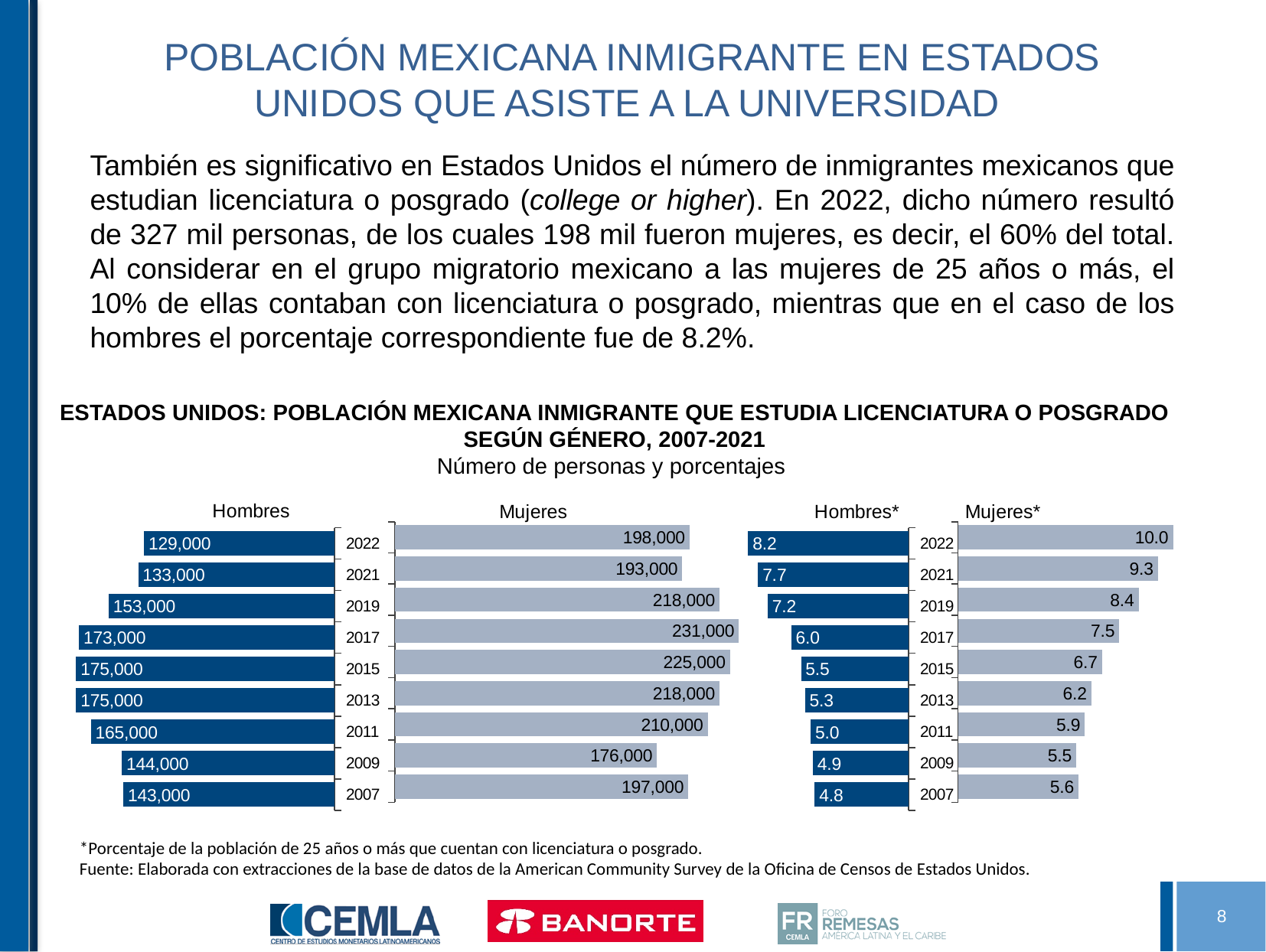
In the right chart (percentages), what is the value for Mujeres* in 2022? 10.0 In the right chart (percentages), what is the difference between the Mujeres* and Hombres* values in 2021? 1.6 In the right chart (percentages), do the Hombres* values rise or fall from 2007 to 2022? Rise In the left chart (number of persons), what is the value for Hombres in 2022? 129,000 In the left chart (number of persons), what is the difference between the Mujeres and Hombres values in 2022? 69,000 In the right chart (percentages), which is larger in 2019: Hombres* or Mujeres*? Mujeres* In the left chart (number of persons), which year has the highest value for Mujeres? 2017 What kind of chart is the left chart (number of persons)? Bar chart In the left chart (number of persons), what is the value for Mujeres in 2017? 231,000 How many years are shown on the left chart (number of persons)? 9 In the left chart (number of persons), which year has the lowest value for Hombres? 2022 In the right chart (percentages), what is the value for Hombres* in 2007? 4.8